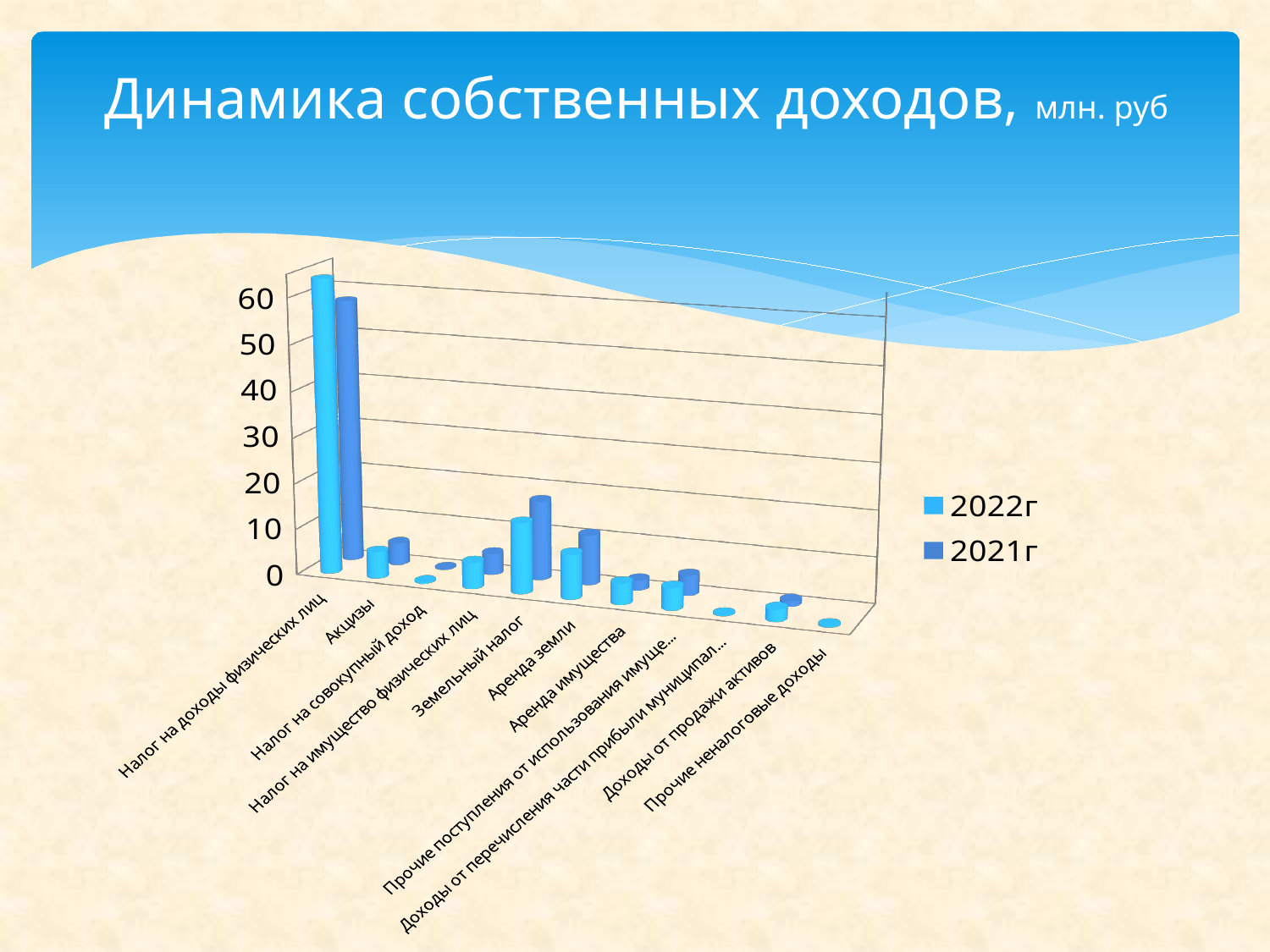
Which category has the highest value for the 2021г series? Налог на доходы физических лиц What is the title of the chart? Динамика собственных доходов, млн. руб How many series does the legend list? 2 What kind of chart is shown on the slide? bar chart For Земельный налог, which series has the larger value, 2022г or 2021г? 2021г For Налог на доходы физических лиц, which series has the larger value, 2022г or 2021г? 2022г Which series are listed in the legend? 2022г and 2021г Is the 2022г value for Акцизы greater or less than 10? less Is the 2021г value for Налог на доходы физических лиц greater or less than 50? greater Is the 2022г value for Налог на доходы физических лиц greater or less than 50? greater How many categories are shown on the x axis? 11 Which category has the highest value for the 2022г series? Налог на доходы физических лиц